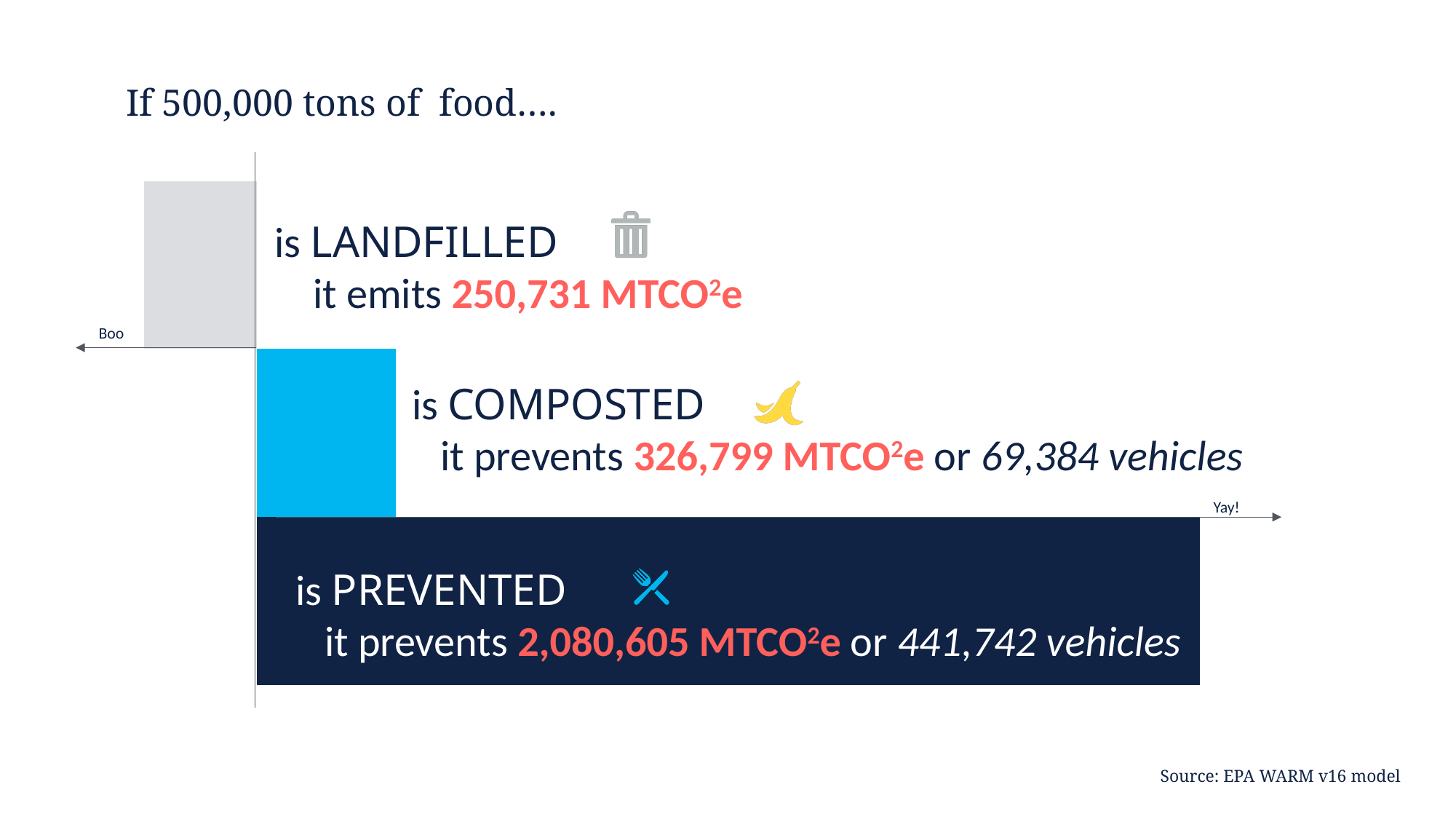
How many vehicles is the composting scenario equivalent to? 69,384 vehicles Which prevents more MTCO²e: composting or prevention? prevention What is the title text above the chart? If 500,000 tons of food.... How many scenarios (bars) does the chart show? 3 How many MTCO²e does the chart say are emitted if the food is landfilled? 250,731 MTCO²e How many vehicles is the prevention scenario equivalent to? 441,742 vehicles How many more MTCO²e does the prevented scenario avoid than the composted scenario? 1,753,806 MTCO²e What kind of chart is shown on the slide? bar chart Which scenario is the only one that emits rather than prevents MTCO²e? LANDFILLED How many MTCO²e are prevented if the food is composted? 326,799 MTCO²e Which scenario prevents the most MTCO²e? PREVENTED How many MTCO²e are prevented if the food is prevented (not wasted)? 2,080,605 MTCO²e